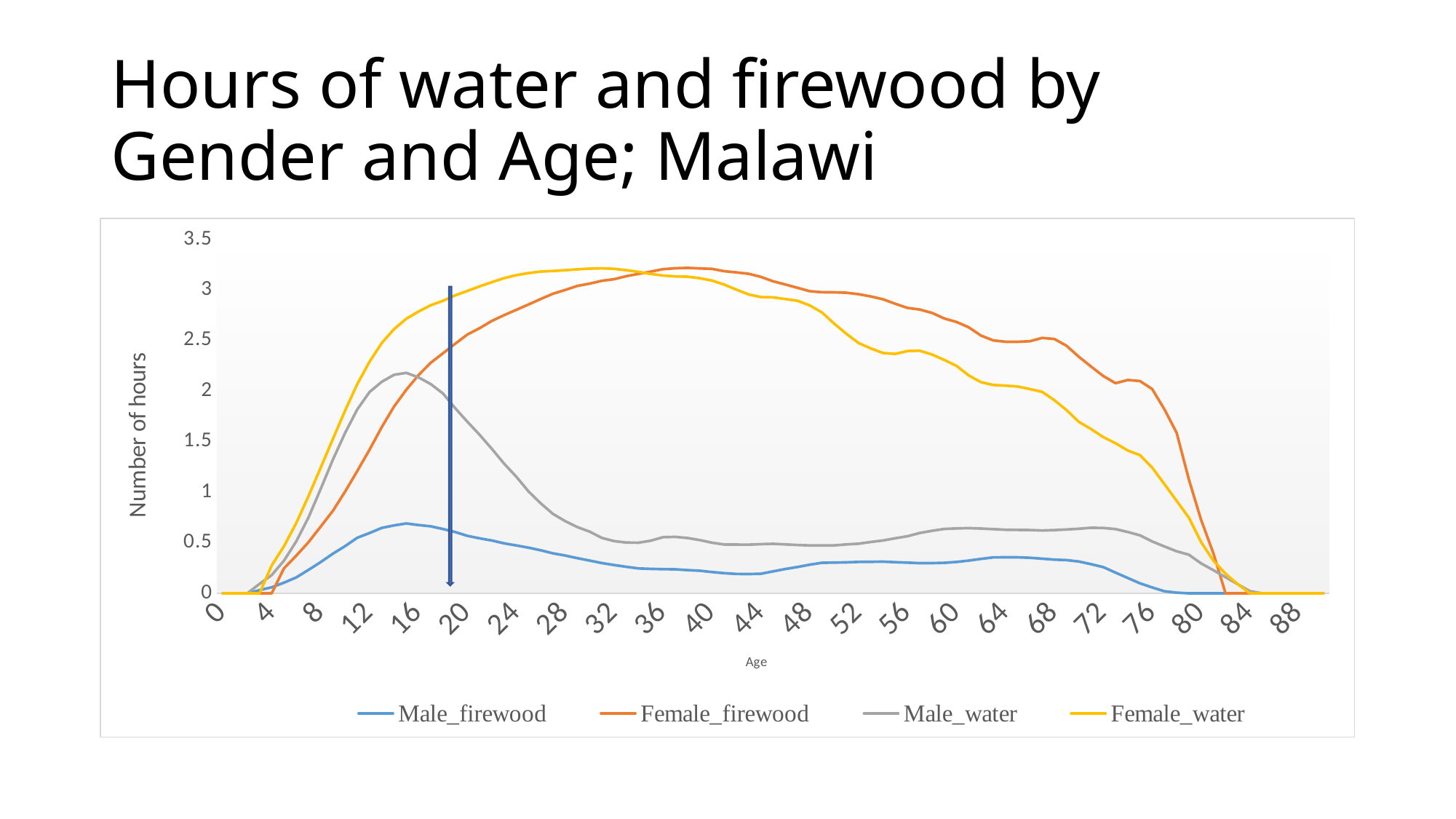
Is the value for Male_water at age 12 greater or less than 1.5? greater Does the Female_water series rise or fall between age 32 and age 80? fall What kind of chart is shown on the slide? line chart Is the value for Male_firewood at age 40 greater or less than 0.5? less What is the title of the slide? Hours of water and firewood by Gender and Age; Malawi Which series has the lowest peak value across all ages? Male_firewood What is the label on the vertical axis of the chart? Number of hours At age 12, which series has the larger value: Male_water or Female_firewood? Male_water How many series does the legend list? 4 Is the value for Female_water at age 76 greater or less than 2? less At age 60, which series has the larger value: Female_firewood or Female_water? Female_firewood